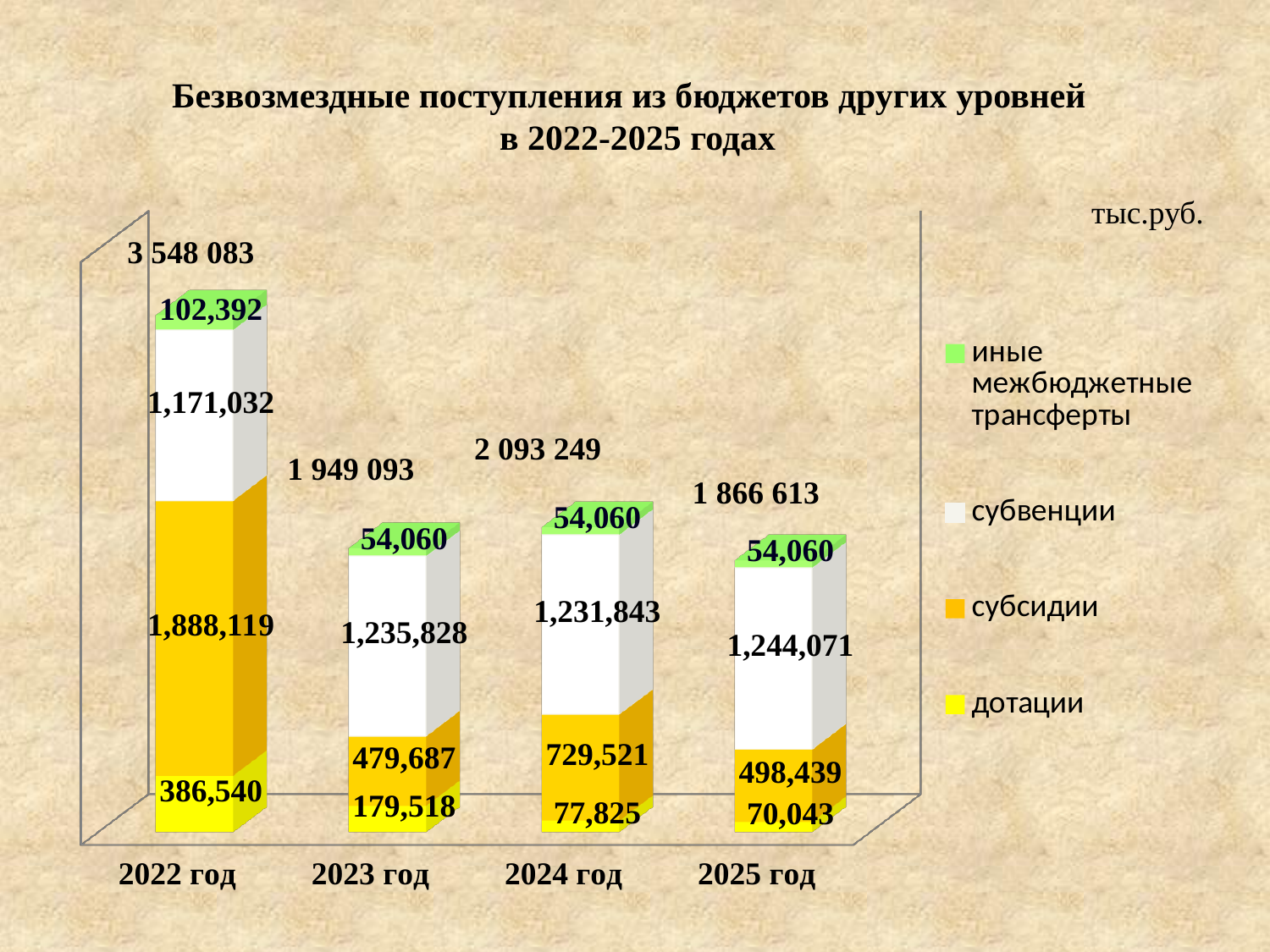
Which year has the lowest value of дотации? 2025 год What kind of chart is shown on the slide? stacked bar chart What is the value of субсидии for 2022 год? 1,888,119 Which year has the highest total of безвозмездные поступления? 2022 год Which is larger: субсидии in 2025 год or субсидии in 2023 год? субсидии in 2025 год What is the value of дотации for 2024 год? 77,825 What is the difference between субсидии in 2024 год and 2023 год? 249,834 How many years (categories) are shown on the x axis? 4 What is the value of иные межбюджетные трансферты for 2022 год? 102,392 How many series does the legend list? 4 What is the total of the stacked bar for 2024 год? 2 093 249 What is the value of субвенции for 2025 год? 1,244,071